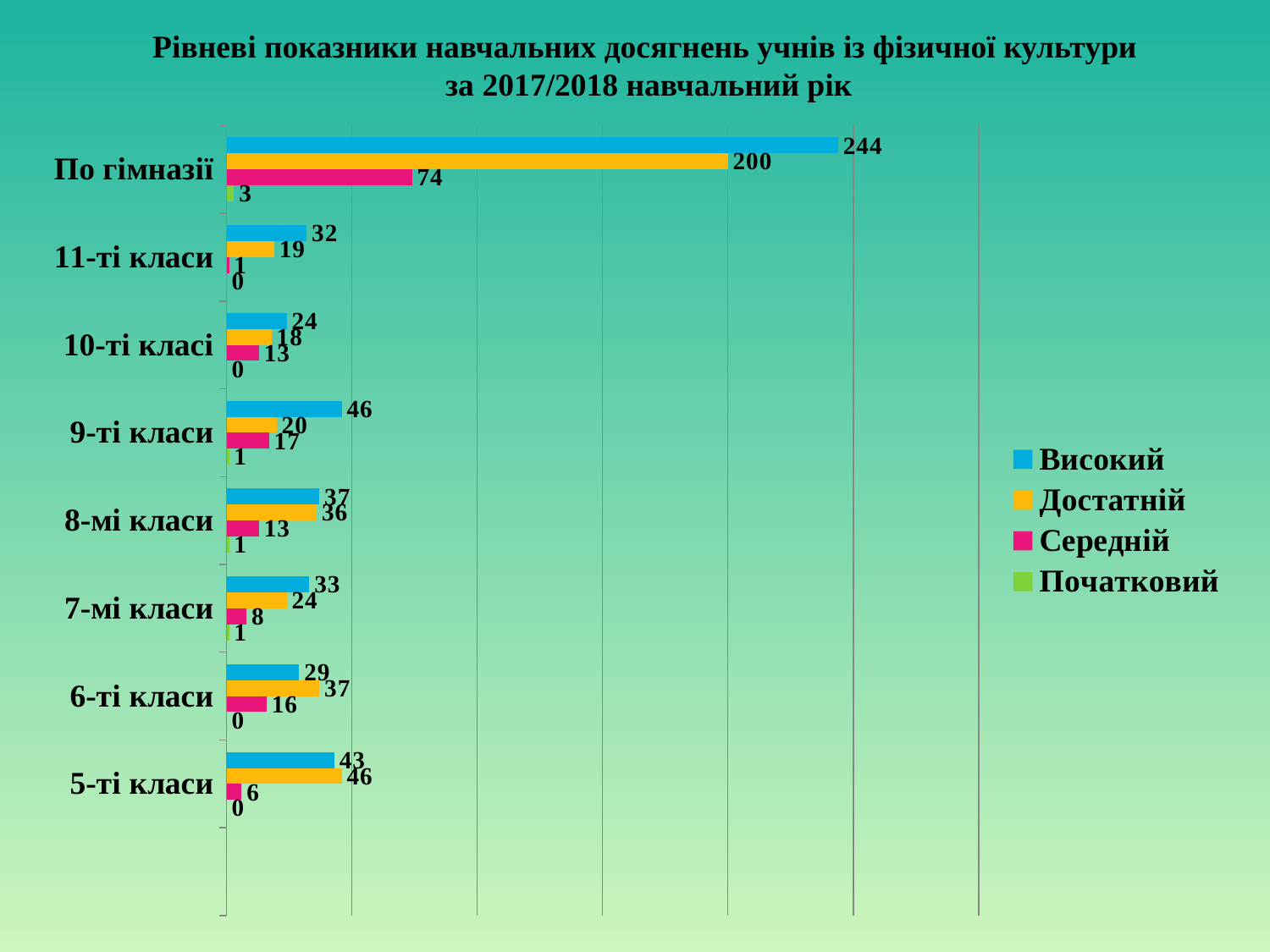
What is the value of Середній for 10-ті класі? 13 How many categories are shown on the vertical axis? 8 What kind of chart is shown on the slide? Bar chart What is the value of Початковий for По гімназії? 3 Which colour represents the Середній series in the legend? Pink What is the value of Достатній for 6-ті класи? 37 What is the value of Високий for По гімназії? 244 Among the class categories (excluding По гімназії), which has the highest Високий value? 9-ті класи Which is larger for 5-ті класи: Високий or Достатній? Достатній Among the class categories (excluding По гімназії), which has the lowest Середній value? 11-ті класи How many series does the legend list? 4 What is the difference between the Високий and Достатній values for По гімназії? 44